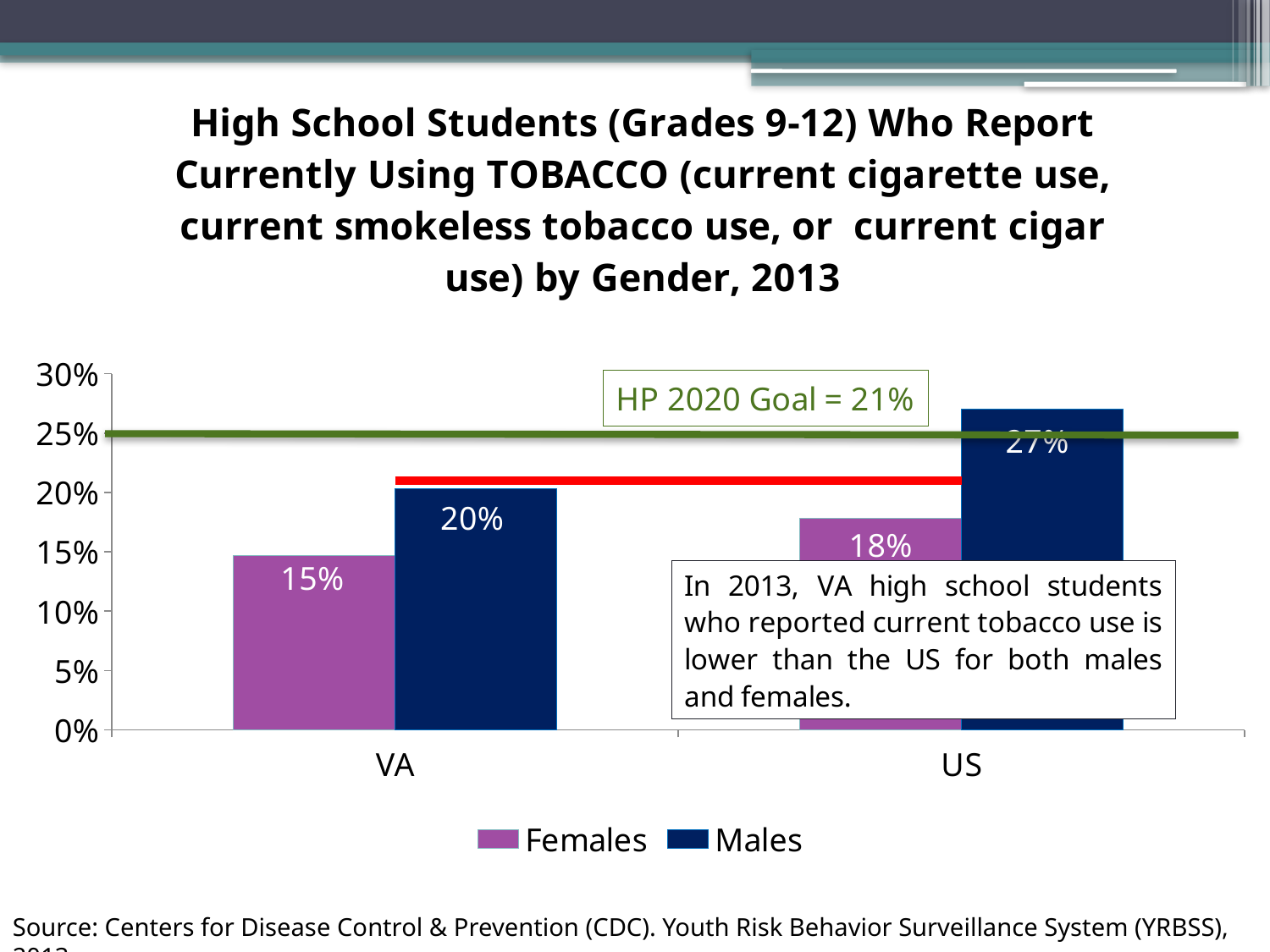
Is the value for Males in the US greater or less than 25%? greater What kind of chart is shown on the slide? Bar chart Which bar is the highest on the chart? US Males What is the value for Males in VA? 20% How many categories are shown on the x axis? 2 What is the difference between the Females values for the US and VA? 3 percentage points How many series does the legend list? 2 Which bar is the lowest on the chart? VA Females Which is larger, the Females value for VA or the Females value for the US? US What is the value for Females in the US? 18% What is the difference between the Males and Females values for VA? 5 percentage points What is the value for Females in VA? 15%